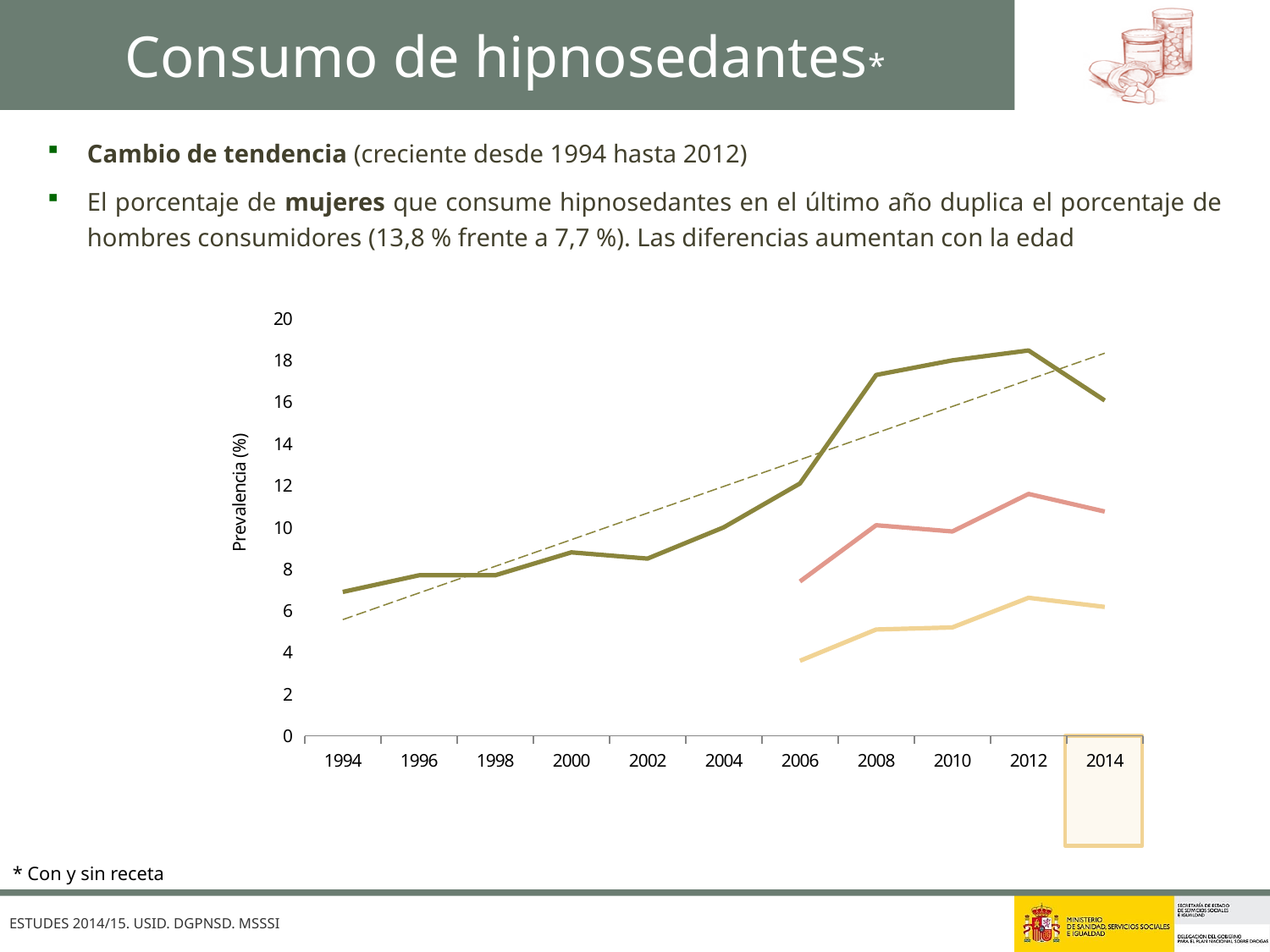
Is the value of the dark olive line in 2014 greater or less than 14? greater In which year does the light yellow line have its lowest value? 2006 Does the dark olive line rise or fall between 2012 and 2014? fall Is the value of the pink line in 2012 greater or less than 10? greater In which year does the dark olive line have its lowest value? 1994 Is the value of the light yellow line in 2006 greater or less than 6? less Does the dark olive line rise or fall between 1994 and 2012? rise How many years are labelled on the x axis of the chart? 11 What is the label of the vertical axis of the chart? Prevalencia (%) In 2014, which line has the larger value, the dark olive line or the pink line? the dark olive line In which year does the dark olive line reach its highest value? 2012 What kind of chart is shown on the slide? line chart